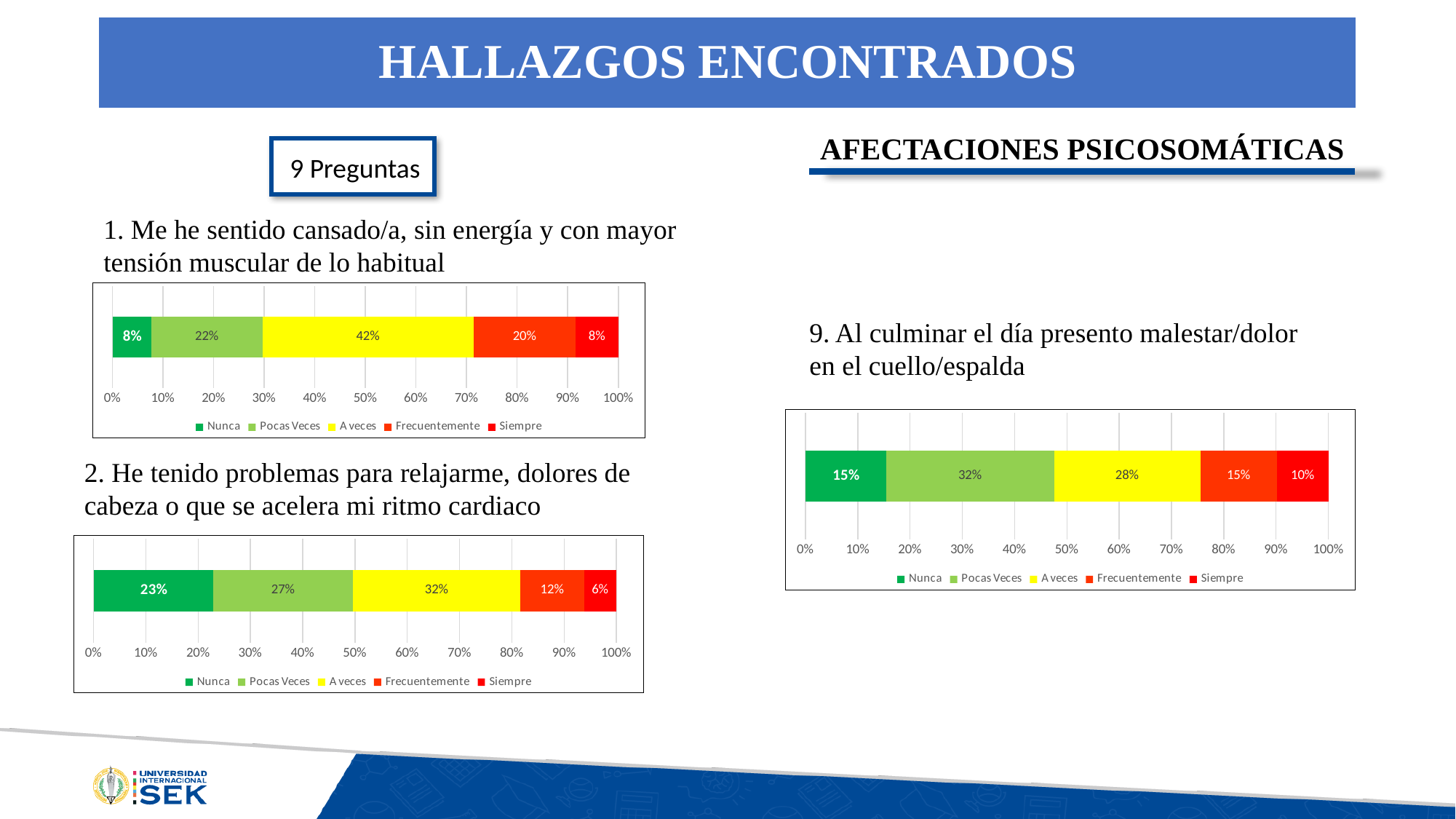
In the chart for question 9 ("Al culminar el día presento malestar/dolor..."), what percentage is shown for "Siempre"? 10% In the chart for question 1 ("Me he sentido cansado/a..."), what percentage is shown for "A veces"? 42% In the chart for question 9 ("Al culminar el día presento malestar/dolor..."), what percentage is shown for "Pocas Veces"? 32% In the chart for question 9 ("Al culminar el día presento malestar/dolor..."), what is the combined percentage of "Frecuentemente" and "Siempre"? 25% In the chart for question 2 ("He tenido problemas para relajarme..."), what percentage is shown for "Nunca"? 23% What type of chart is used for question 2 ("He tenido problemas para relajarme...")? Stacked bar chart In the chart for question 1 ("Me he sentido cansado/a..."), what percentage is shown for "Pocas Veces"? 22% In the chart for question 1 ("Me he sentido cansado/a..."), which response category has the largest share? A veces In the chart for question 2 ("He tenido problemas para relajarme..."), what is the difference between the "A veces" and "Frecuentemente" percentages? 20% In the chart for question 9 ("Al culminar el día presento malestar/dolor..."), which is larger, "Pocas Veces" or "A veces"? Pocas Veces In the chart for question 2 ("He tenido problemas para relajarme..."), which response category has the smallest share? Siempre How many series does the legend list in the chart for question 1 ("Me he sentido cansado/a...")? 5